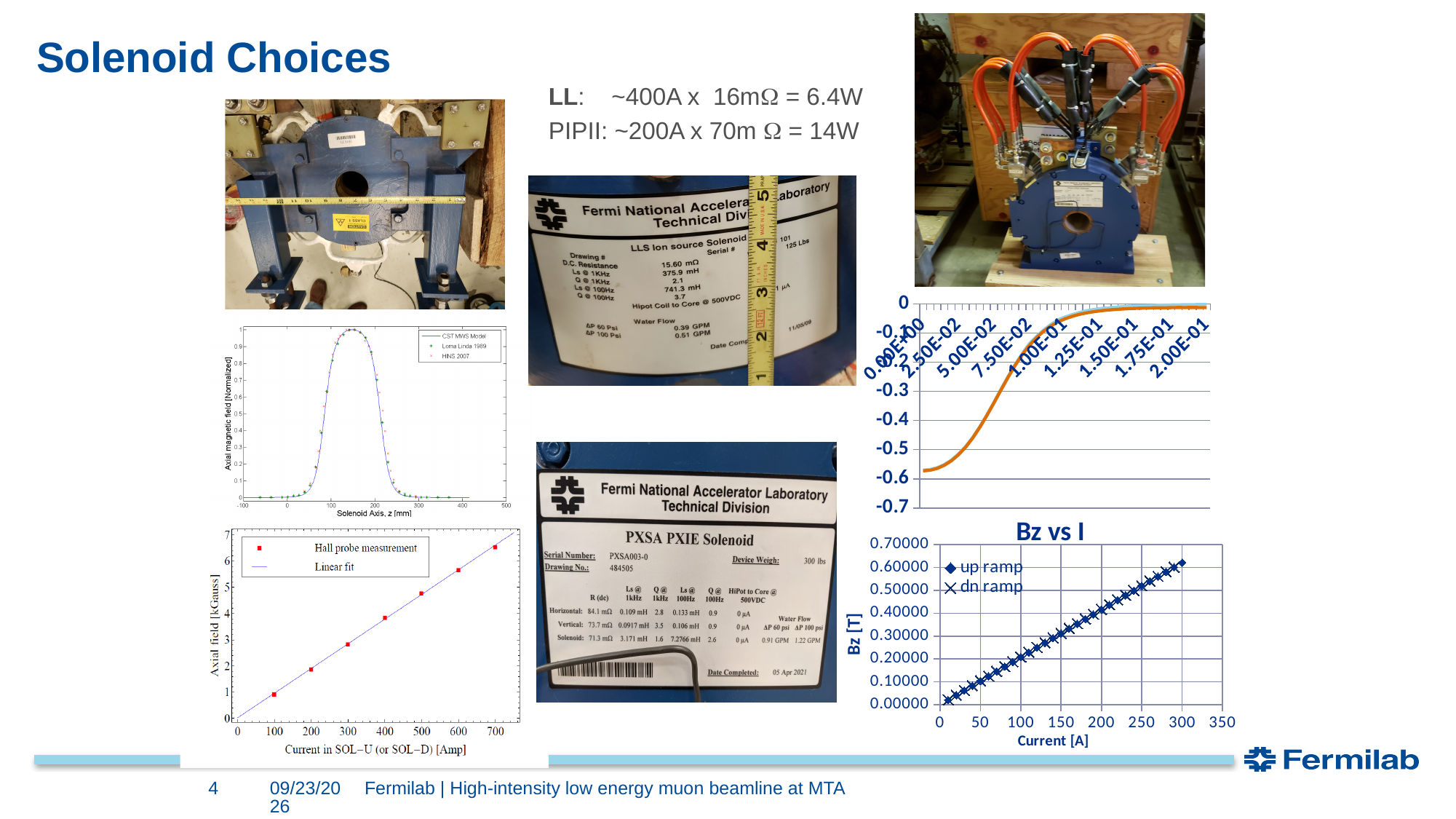
In the 'Bz vs I' chart, how many series does the legend list? 2 In the bottom-left chart of axial field versus current, how many series does the legend list? 2 In the 'Bz vs I' chart, what are the two legend entries? up ramp, dn ramp In the bottom-left chart of axial field versus current, does the axial field rise or fall as the current increases? rise In the bottom-left chart of axial field versus current, is the axial field at 700 Amp greater or less than 6 kGauss? greater In the 'Bz vs I' chart, is the value of Bz at 300 A greater or less than 0.50000? greater In the bottom-left chart of axial field versus current, how many Hall probe measurement points are plotted? 7 In the chart on the right with the x axis from 0.00E+00 to 2.00E-01, is the value at 0.00E+00 greater or less than -0.5? less In the chart of normalized axial magnetic field versus solenoid axis, how many series does the legend list? 3 In the 'Bz vs I' chart, what is the x-axis title? Current [A] In the 'Bz vs I' chart, does Bz rise or fall as the current increases? rise